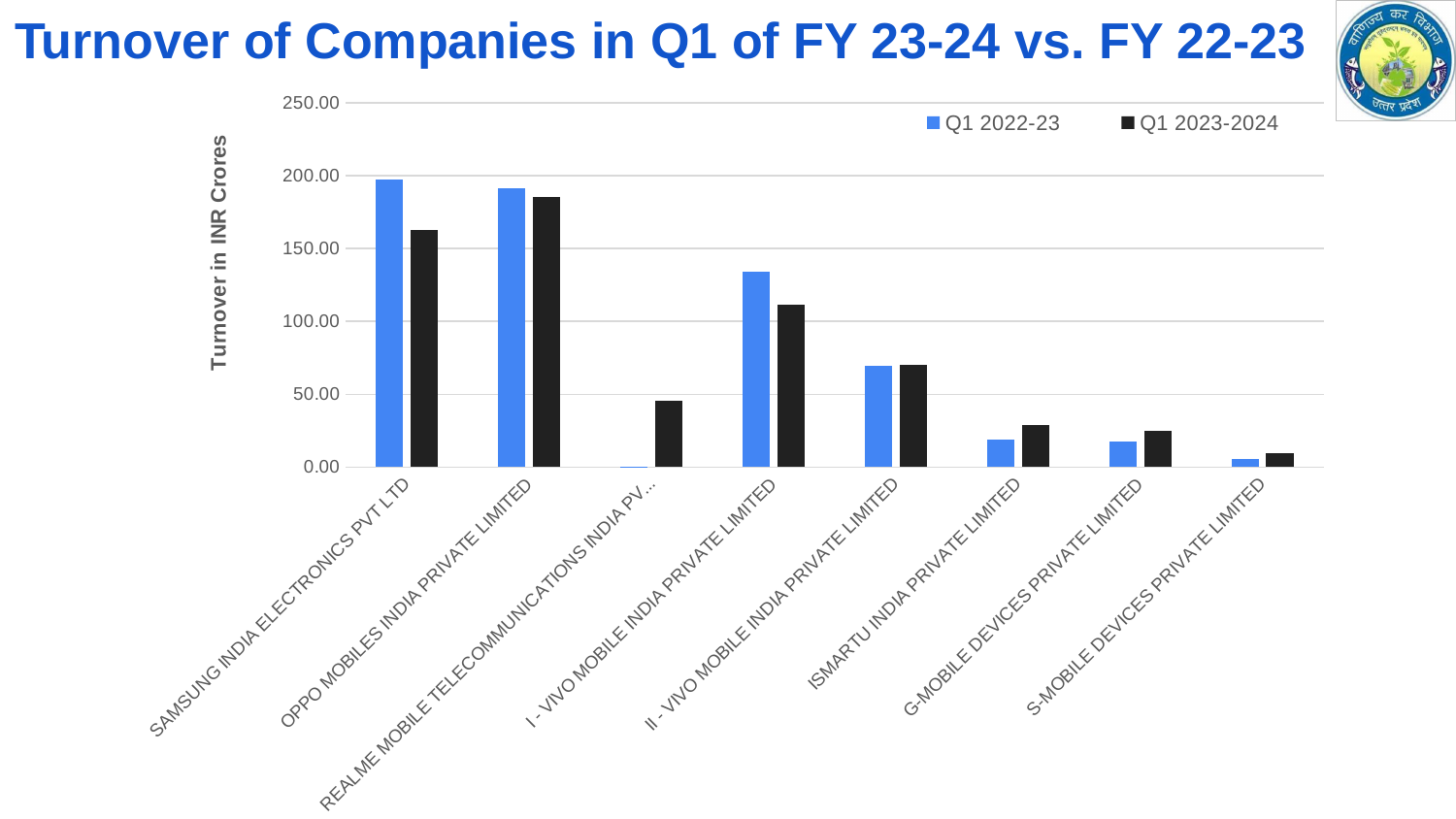
For REALME MOBILE TELECOMMUNICATIONS INDIA PV..., which is larger: the Q1 2022-23 turnover or the Q1 2023-2024 turnover? Q1 2023-2024 Is the Q1 2023-2024 turnover for ISMARTU INDIA PRIVATE LIMITED greater or less than 50.00? less Which company has the highest Q1 2023-2024 turnover? OPPO MOBILES INDIA PRIVATE LIMITED For SAMSUNG INDIA ELECTRONICS PVT LTD, which is larger: the Q1 2022-23 turnover or the Q1 2023-2024 turnover? Q1 2022-23 Is the Q1 2023-2024 turnover for I - VIVO MOBILE INDIA PRIVATE LIMITED greater or less than 100.00? greater How many series does the chart's legend list? 2 What is the label on the vertical axis of the chart? Turnover in INR Crores Which company has the lowest Q1 2022-23 turnover? REALME MOBILE TELECOMMUNICATIONS INDIA PV... What kind of chart is shown on the slide? Bar chart How many companies are shown on the x axis of the chart? 8 Is the Q1 2022-23 turnover for SAMSUNG INDIA ELECTRONICS PVT LTD greater or less than 150.00? greater Which company has the lowest Q1 2023-2024 turnover? S-MOBILE DEVICES PRIVATE LIMITED